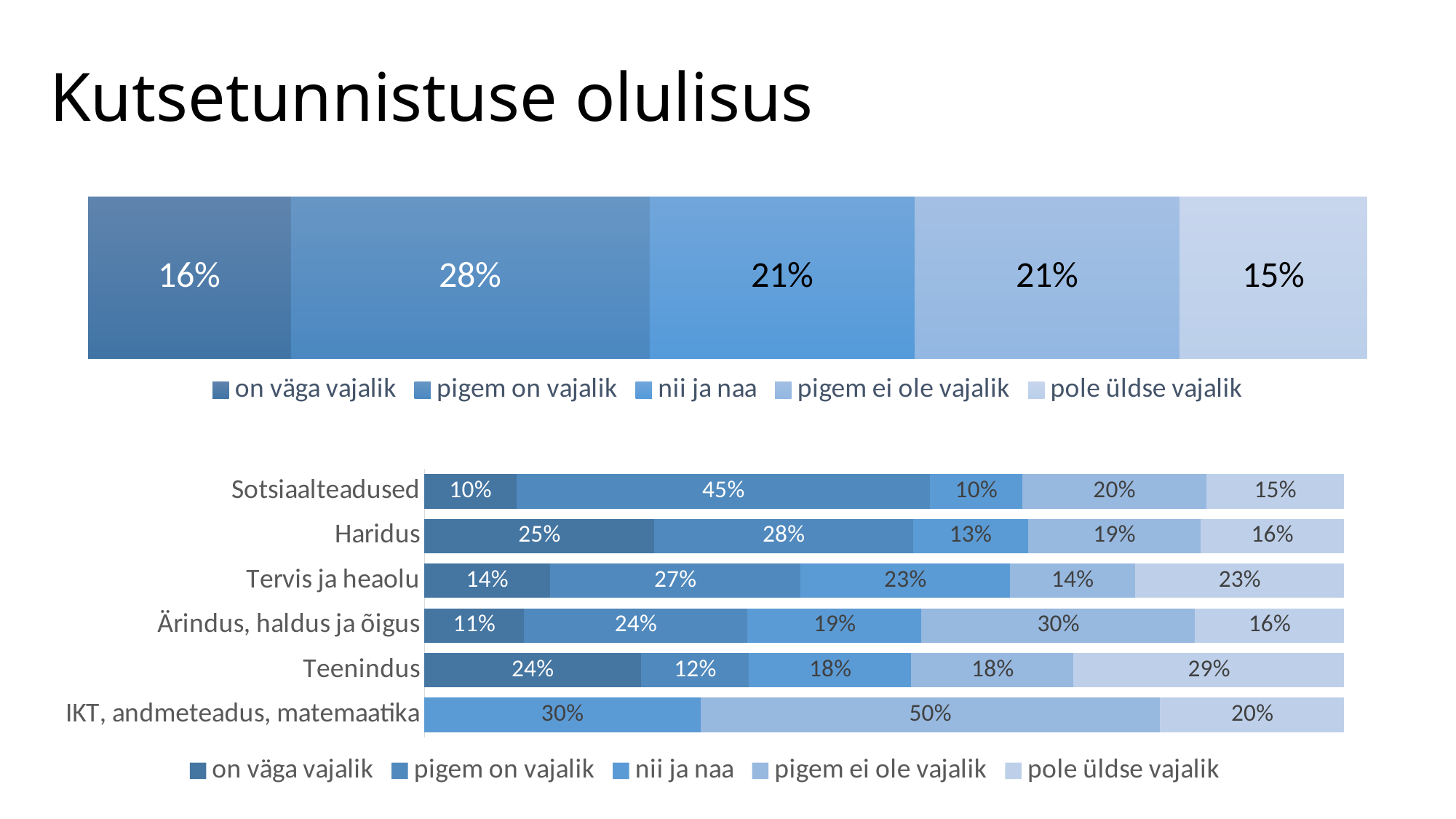
In the bottom chart, what is the difference between the "pigem ei ole vajalik" values for Ärindus, haldus ja õigus and Tervis ja heaolu? 16% In the bottom chart, what is the "pigem on vajalik" value for Sotsiaalteadused? 45% In the bottom chart, what is the "pigem ei ole vajalik" value for IKT, andmeteadus, matemaatika? 50% What is the title of the slide? Kutsetunnistuse olulisus In the bottom chart, which is larger: the "nii ja naa" value for Tervis ja heaolu or for Haridus? Tervis ja heaolu How many series does the legend of the bottom chart list? 5 In the bottom chart, which category has the highest "on väga vajalik" value? Haridus How many categories are shown in the bottom chart? 6 What kind of chart is the bottom chart? Stacked bar chart In the bottom chart, what is the "pole üldse vajalik" value for Teenindus? 29% In the top chart, what is the value for "pigem on vajalik"? 28% In the top chart, which category has the lowest value? pole üldse vajalik